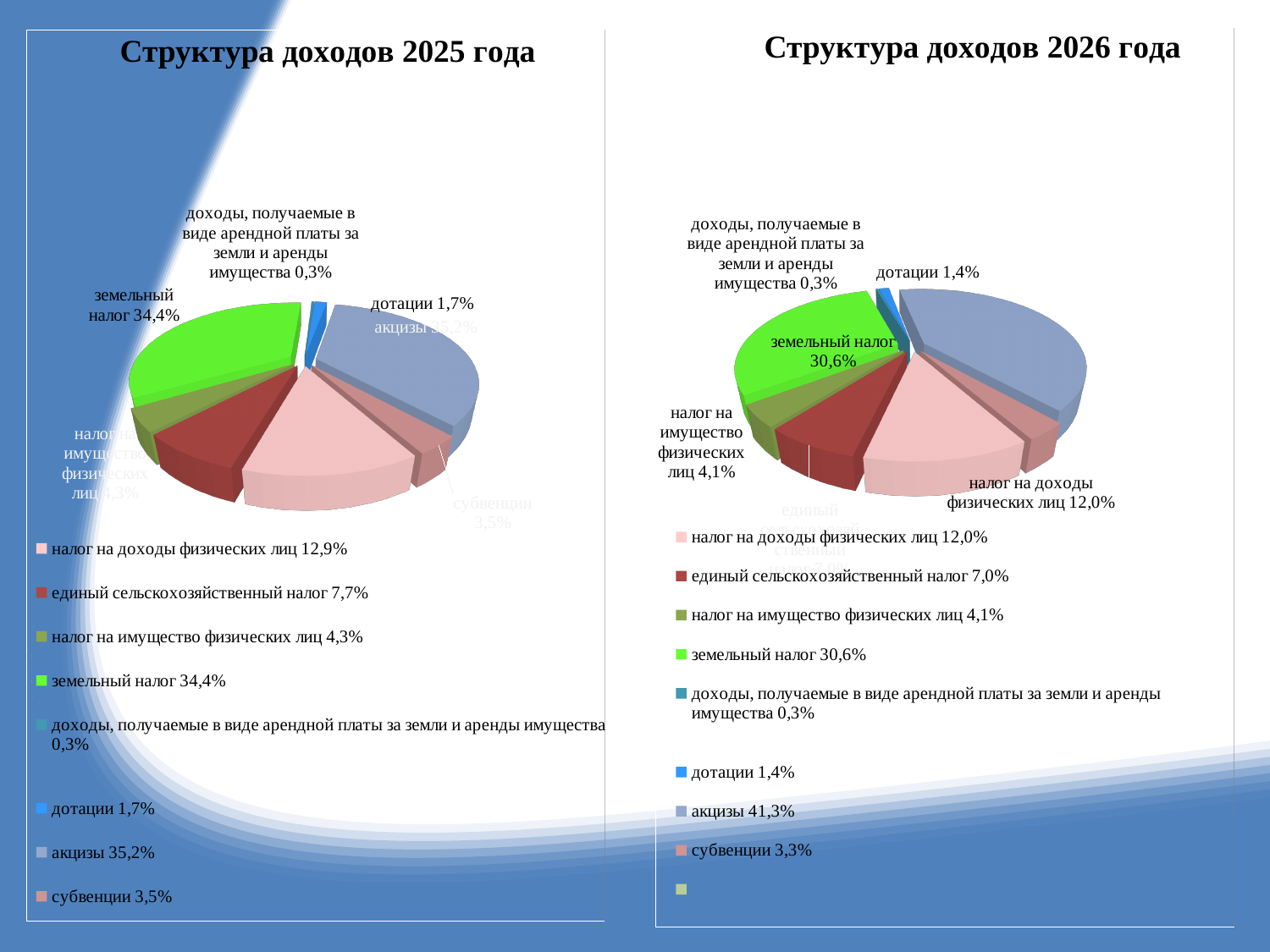
In the chart "Структура доходов 2025 года", what is the share of акцизы? 35,2% In the chart "Структура доходов 2026 года", which category has the largest share? акцизы In the chart "Структура доходов 2025 года", what is the share of земельный налог? 34,4% Comparing the two charts, is the share of акцизы larger in 2025 or in 2026? 2026 In the chart "Структура доходов 2025 года", how many categories does the legend list? 8 In the chart "Структура доходов 2026 года", what is the share of акцизы? 41,3% In the chart "Структура доходов 2025 года", which category has the smallest share? доходы, получаемые в виде арендной платы за земли и аренды имущества What kind of chart is used on the slide for "Структура доходов 2025 года"? pie chart In the chart "Структура доходов 2026 года", which is larger: дотации or субвенции? субвенции In the chart "Структура доходов 2026 года", what is the share of земельный налог? 30,6% In the chart "Структура доходов 2026 года", what is the share of налог на имущество физических лиц? 4,1% In the chart "Структура доходов 2025 года", what is the difference between the shares of налог на доходы физических лиц and единый сельскохозяйственный налог? 5,2%